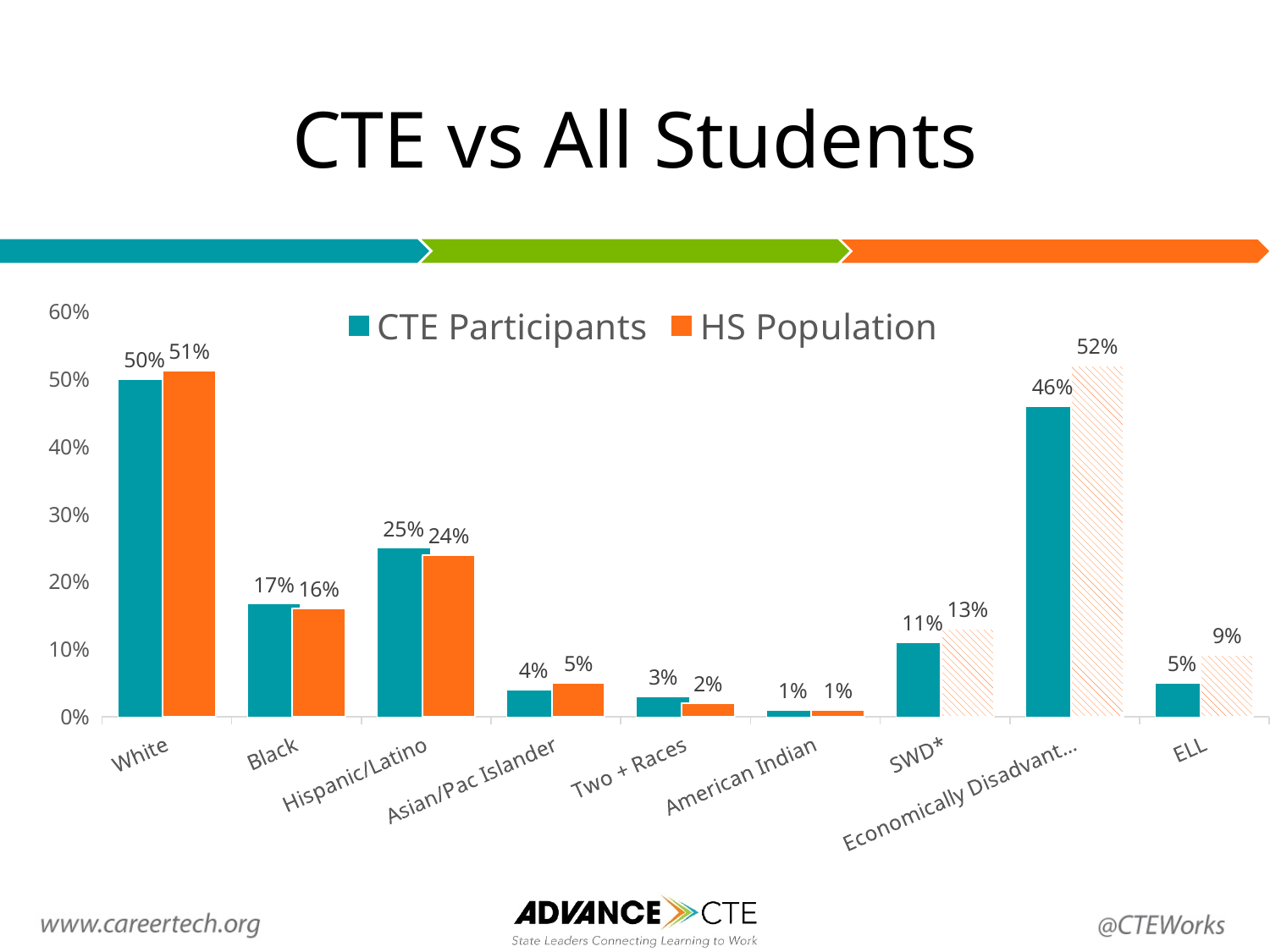
Which category has the lowest HS Population value? American Indian How many categories are shown on the x axis? 9 What is the HS Population value for Economically Disadvantaged students? 52% What is the CTE Participants value for White? 50% Which is larger for Hispanic/Latino: CTE Participants or HS Population? CTE Participants What is the title of the slide? CTE vs All Students What is the difference between the HS Population and CTE Participants values for Economically Disadvantaged students? 6% What kind of chart is shown on the slide? Bar chart How many series does the legend list? 2 What is the CTE Participants value for SWD*? 11% What is the HS Population value for ELL? 9% Which category has the highest CTE Participants value? White